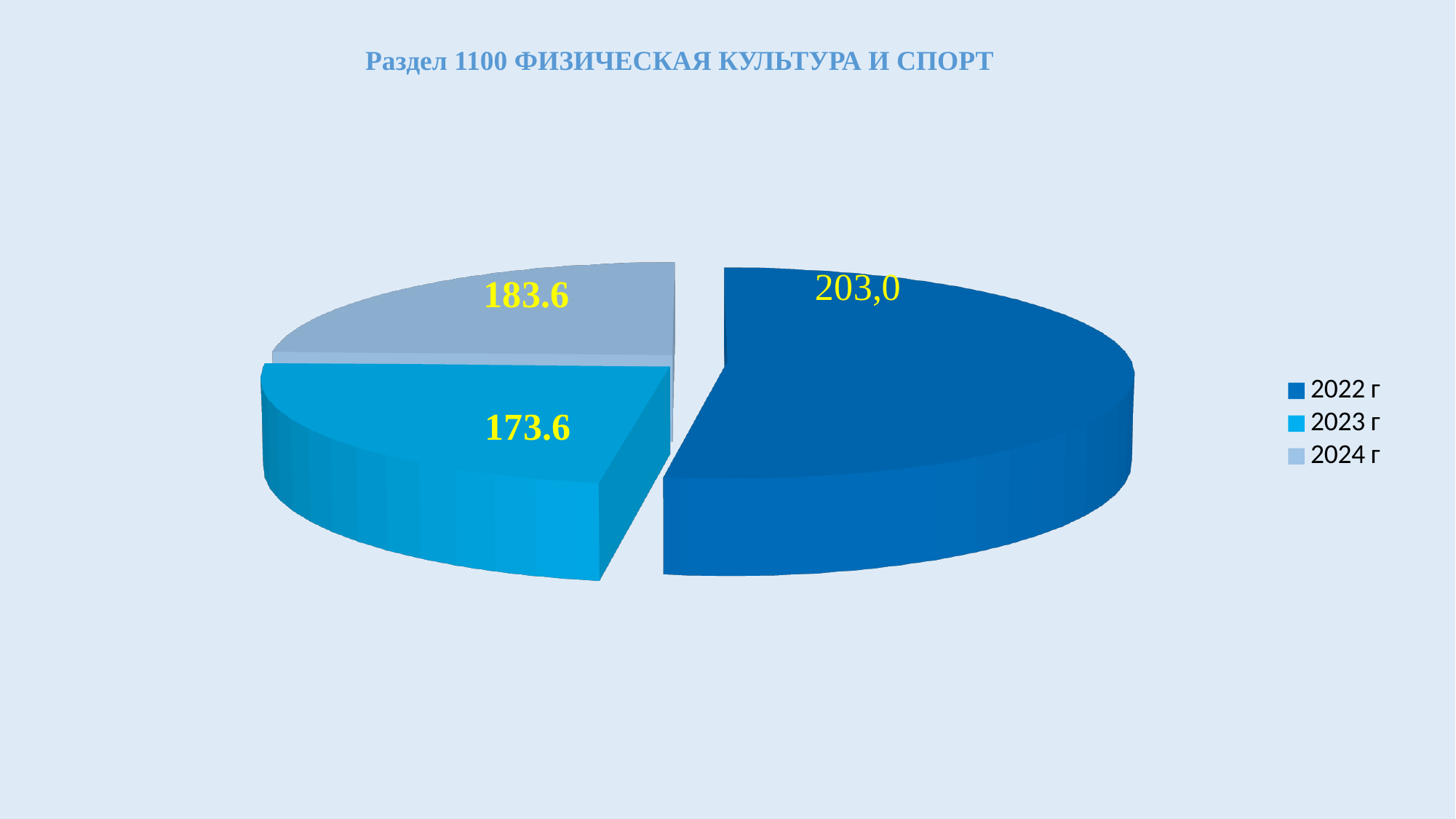
What type of chart is shown on the slide? pie chart What is the value for 2023 г? 173.6 Which year has the largest slice? 2022 г What is the difference between the values for 2022 г and 2023 г? 29.4 Which year has the smallest slice? 2023 г What is the value for 2022 г? 203,0 What is the title of the slide? Раздел 1100 ФИЗИЧЕСКАЯ КУЛЬТУРА И СПОРТ How many slices does the pie chart have? 3 How many entries does the legend list? 3 What is the value for 2024 г? 183.6 Which is larger, the value for 2024 г or the value for 2023 г? 2024 г What is the difference between the values for 2024 г and 2023 г? 10.0